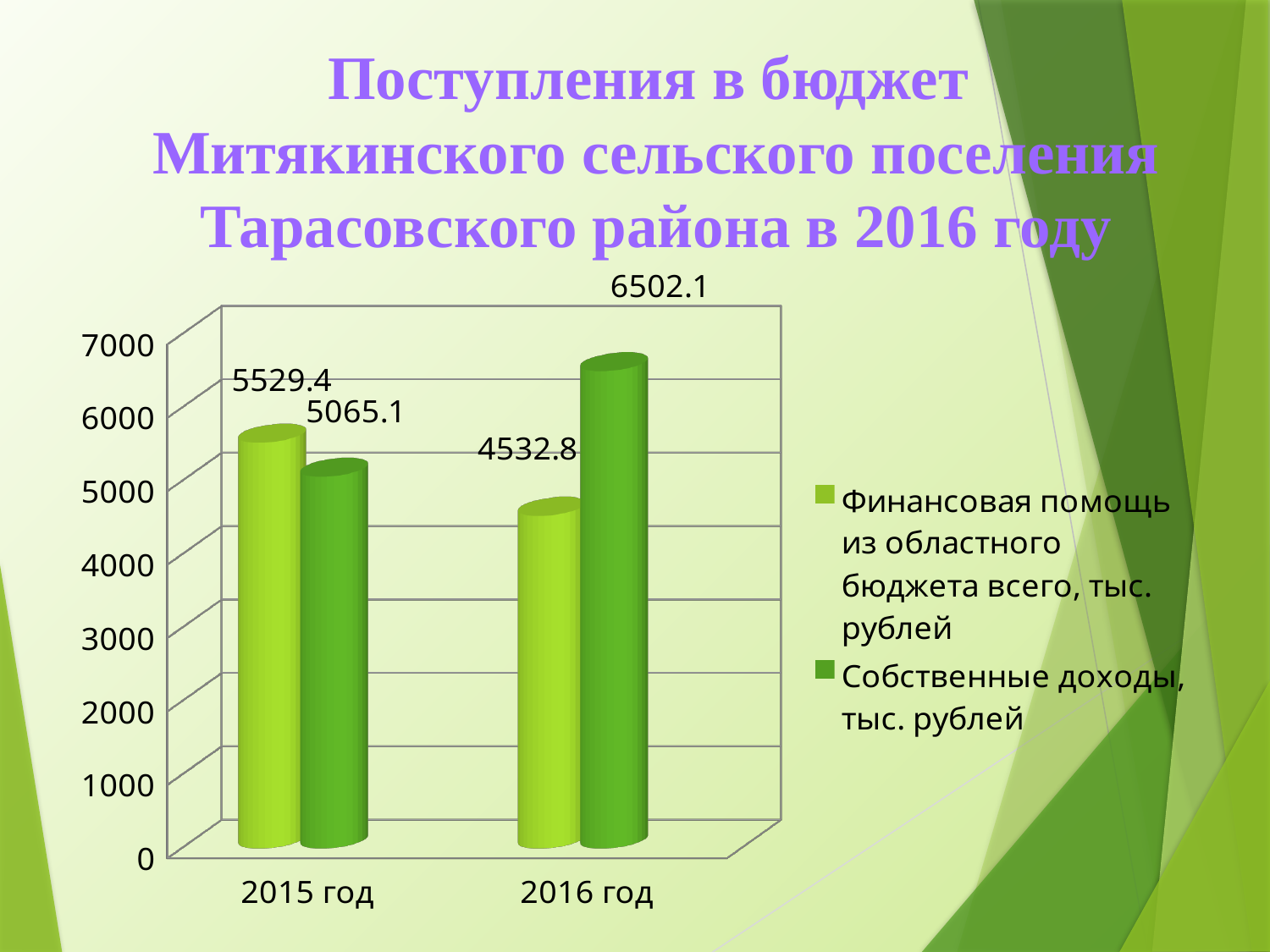
What is the value of Собственные доходы, тыс. рублей for 2015 год? 5065.1 What is the difference between Финансовая помощь из областного бюджета in 2015 год and in 2016 год? 996.6 What is the value of Финансовая помощь из областного бюджета всего, тыс. рублей for 2015 год? 5529.4 What is the difference between Собственные доходы and Финансовая помощь из областного бюджета in 2016 год? 1969.3 How does Собственные доходы, тыс. рублей change from 2015 год to 2016 год? It rises In 2015 год, which is larger: Финансовая помощь из областного бюджета or Собственные доходы? Финансовая помощь из областного бюджета What kind of chart is shown on the slide? Bar chart How many series does the legend list? 2 What is the value of Собственные доходы, тыс. рублей for 2016 год? 6502.1 Which bar has the highest value on the chart? Собственные доходы, тыс. рублей for 2016 год Which bar has the lowest value on the chart? Финансовая помощь из областного бюджета всего, тыс. рублей for 2016 год What is the value of Финансовая помощь из областного бюджета всего, тыс. рублей for 2016 год? 4532.8